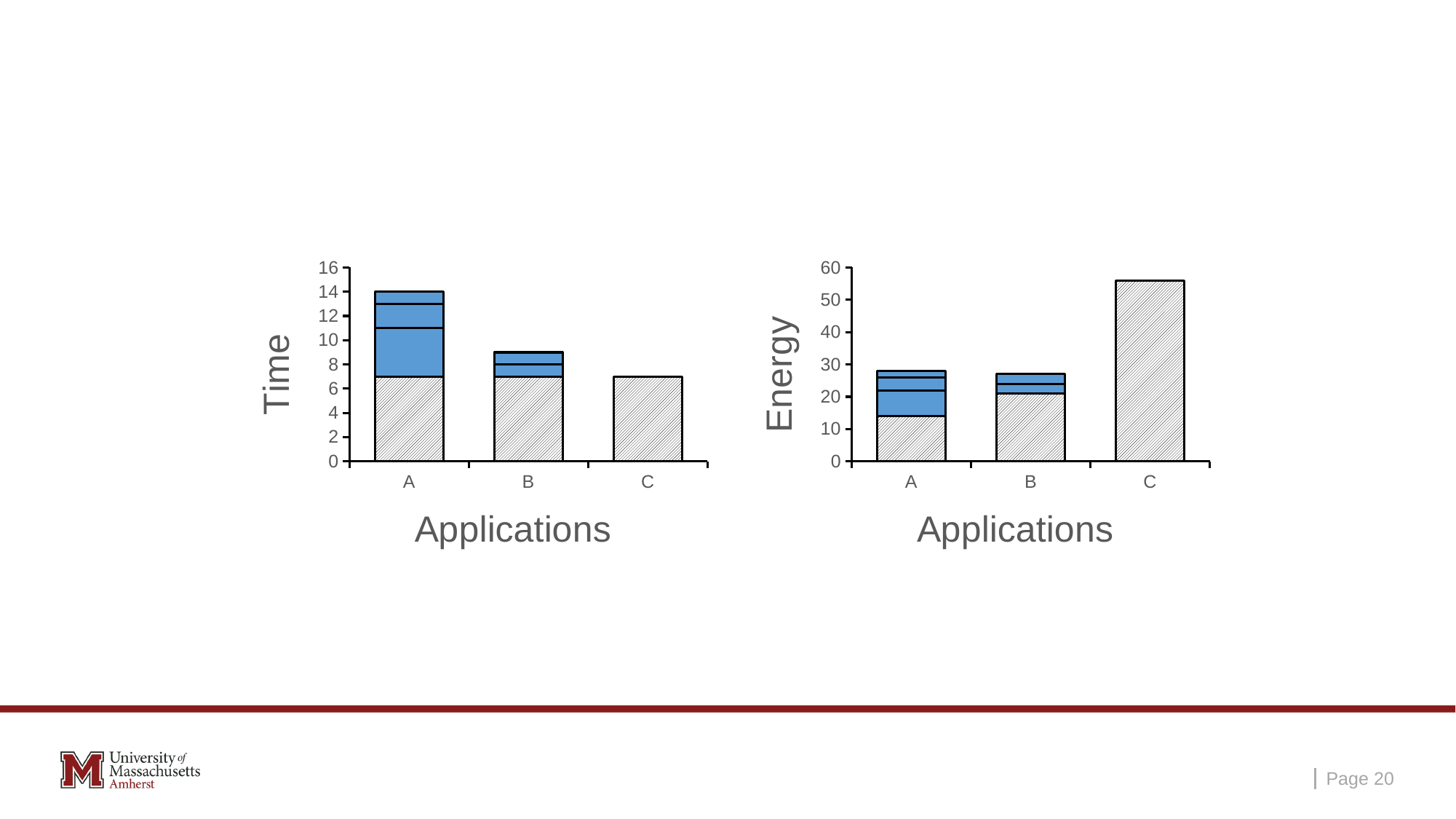
On the right chart (Energy), which is larger, the bar for A or the bar for C? C On the left chart (Time), do the bar heights rise or fall from A to C? fall On the left chart (Time), what is the total height of the stacked bar for application A? 14 On the left chart (Time), which application has the shortest bar? C On the left chart (Time), is the total value for application B greater or less than 8? greater What kind of chart is the left chart (Time)? bar chart On the left chart (Time), which application has the tallest bar? A On the right chart (Energy), which application has the tallest bar? C How many applications are shown on the x axis of the right chart (Energy)? 3 What is the x-axis title of the right chart? Applications On the right chart (Energy), is the total value for application A greater or less than 30? less On the right chart (Energy), is the value for application C greater or less than 50? greater